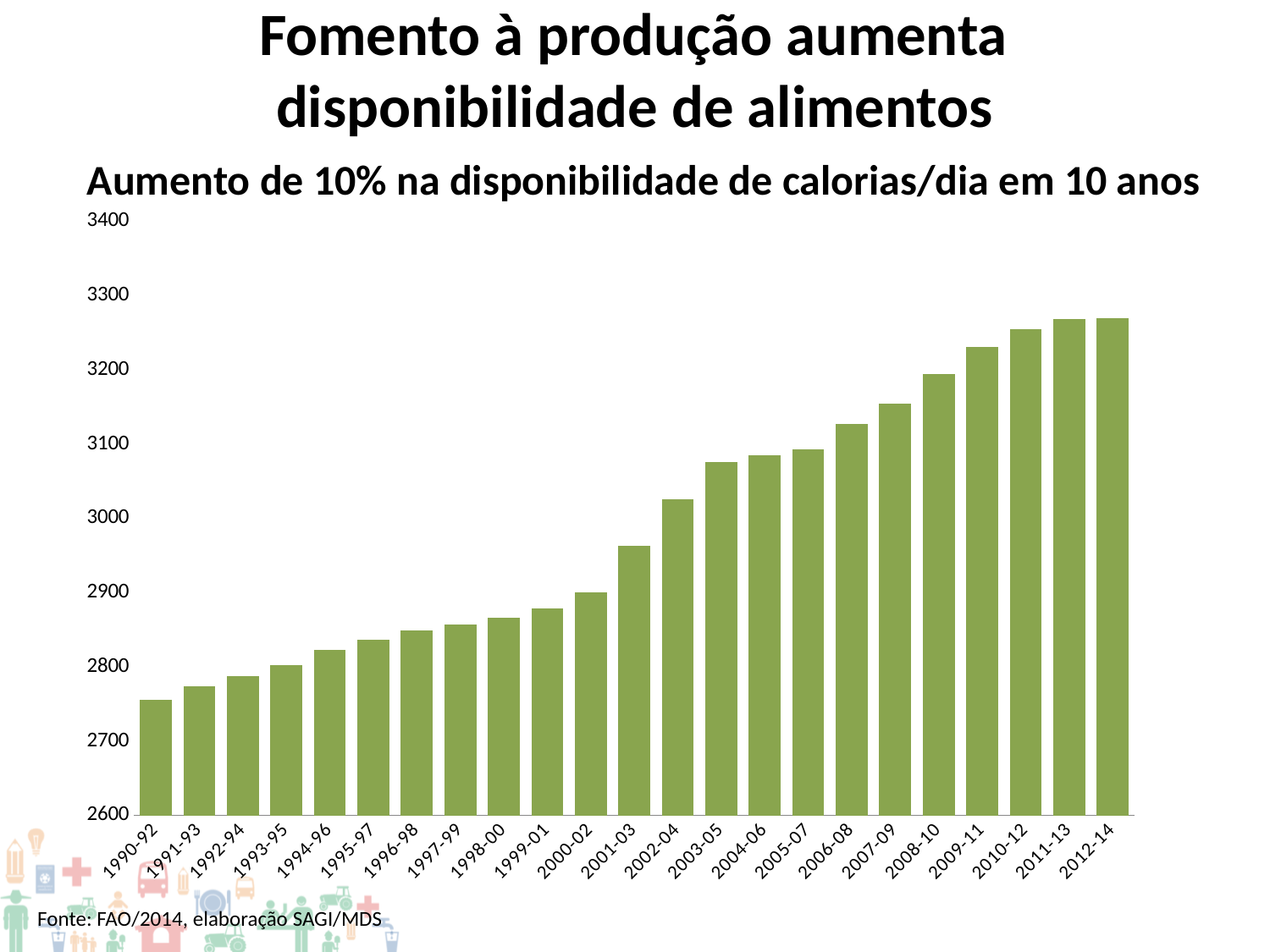
Which period has the lowest value in the chart? 1990-92 Is the value for 2002-04 greater or less than 3000? greater What kind of chart is shown on the slide? bar chart Is the value for 2009-11 greater or less than 3200? greater How many periods (bars) are shown on the x axis of the chart? 23 Is the value for 2001-03 greater or less than 3000? less Which is larger, the value for 2005-07 or the value for 1997-99? 2005-07 Do the values rise or fall from 1990-92 to 2012-14? rise What is the subtitle shown directly above the chart? Aumento de 10% na disponibilidade de calorias/dia em 10 anos